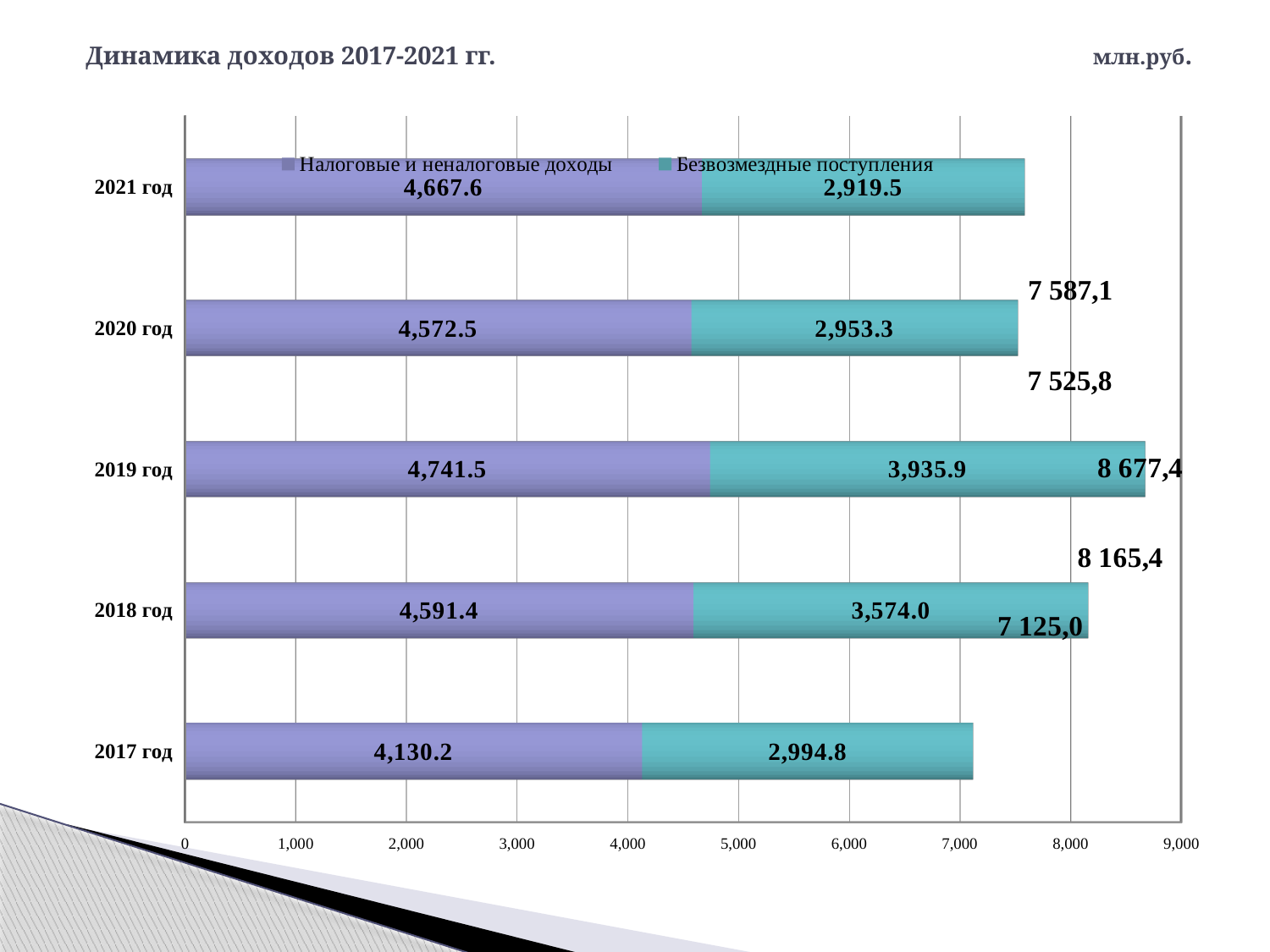
How many years (categories) are shown on the chart? 5 What is the title of the chart? Динамика доходов 2017-2021 гг. Which year has the highest value for Налоговые и неналоговые доходы? 2019 год Which year has the lowest value for Налоговые и неналоговые доходы? 2017 год What is the value of Безвозмездные поступления for 2019 год? 3,935.9 What is the difference between Безвозмездные поступления in 2019 год and in 2018 год? 361.9 Which is larger: Безвозмездные поступления in 2018 год or in 2020 год? 2018 год What is the total of the stacked bar for 2019 год? 8,677.4 What kind of chart is shown on the slide? bar chart What is the value of Налоговые и неналоговые доходы for 2017 год? 4,130.2 How many series does the legend list? 2 Is the total length of the bar for 2019 год greater or less than 8,000? greater